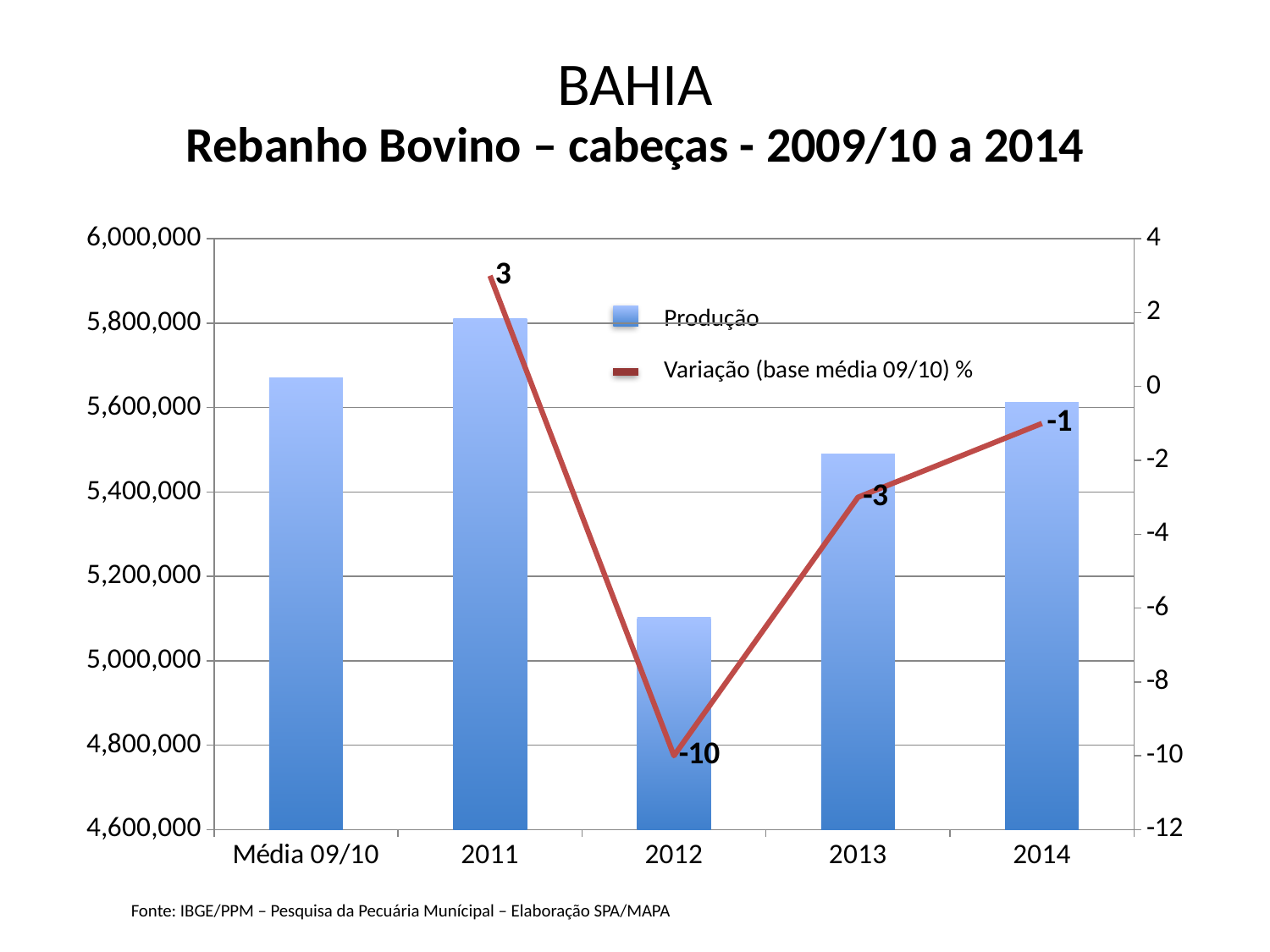
What is the Variação (base média 09/10) % value for 2013? -3 Is the Produção value for 2012 greater or less than 5,200,000? less What is the Variação (base média 09/10) % value for 2011? 3 How many series does the legend list? 2 Which is larger, the Produção bar for 2013 or for 2014? 2014 Which year has the lowest Produção bar? 2012 How many categories are shown on the x axis? 5 What is the difference between the Variação values for 2011 and 2012? 13 What is the Variação (base média 09/10) % value for 2012? -10 Which category has the highest Produção bar? 2011 What is the Variação (base média 09/10) % value for 2014? -1